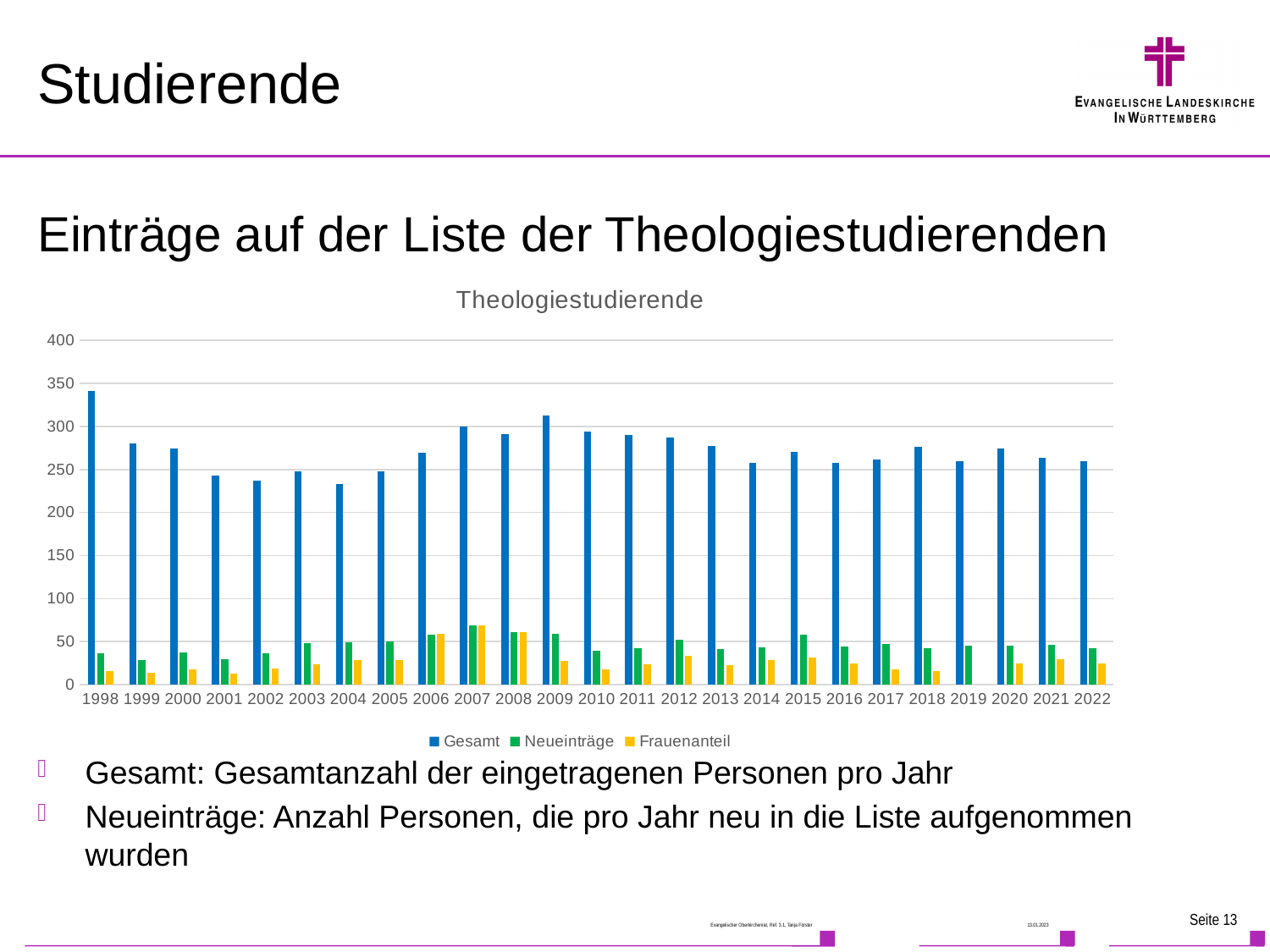
In which year is the Gesamt value highest? 1998 Is the Neueinträge value for 2007 greater or less than 50? greater Which series is shown in blue in the chart? Gesamt Which year has the larger Gesamt value, 2009 or 2010? 2009 Does the Gesamt value rise or fall from 1998 to 2001? fall Is the Frauenanteil value for 1998 greater or less than 50? less What kind of chart is shown on the slide? bar chart What is the title of the chart? Theologiestudierende How many years are shown on the x axis of the chart? 25 Is the Gesamt value for 2004 greater or less than 250? less How many series does the chart's legend list? 3